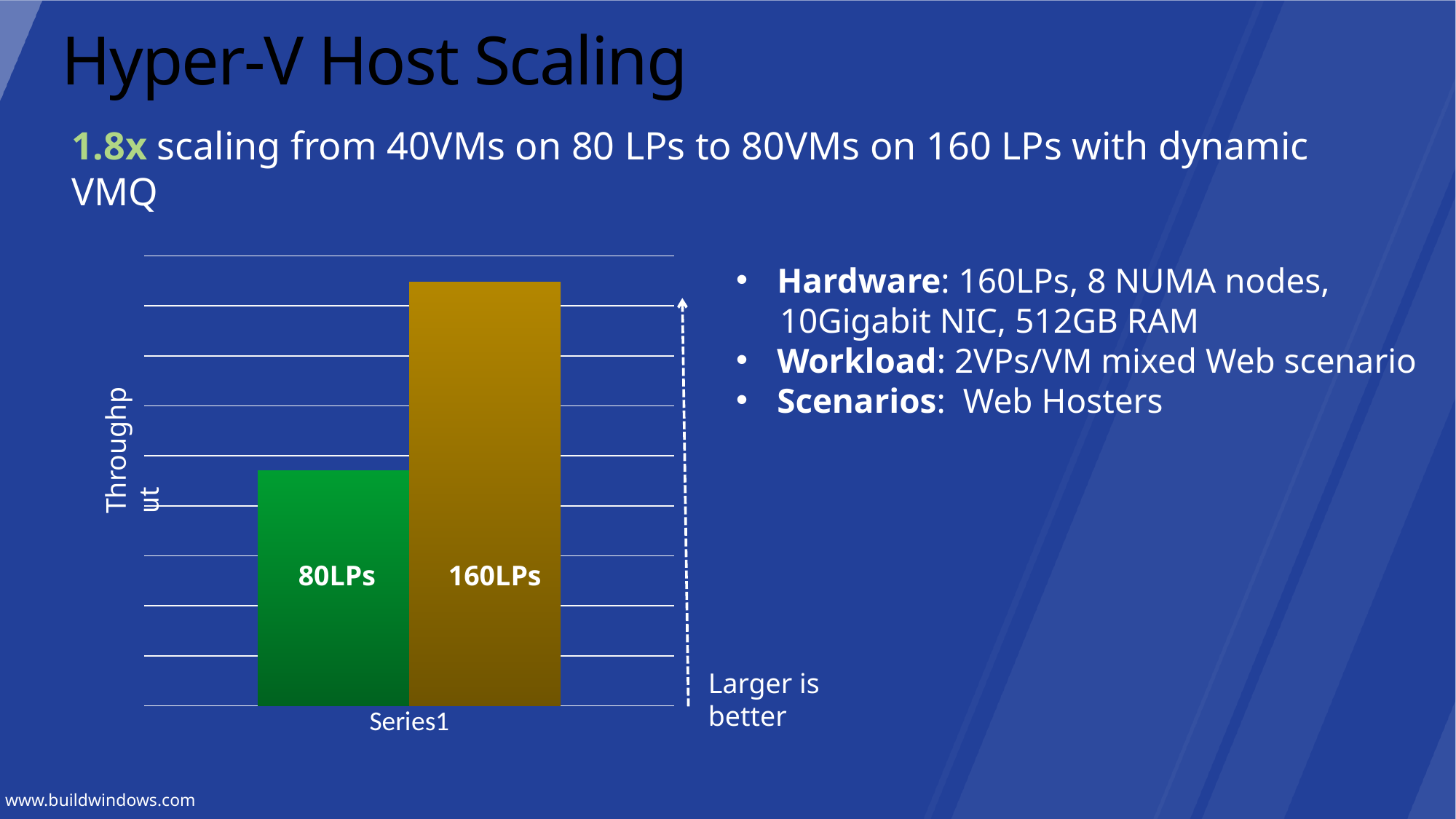
Which bar is the tallest in the chart? 160LPs What is the label on the vertical axis of the chart? Throughput Which bar is taller, 80LPs or 160LPs? 160LPs Does throughput rise or fall going from the 80LPs bar to the 160LPs bar? rise Which bar is the shortest in the chart? 80LPs What is the category label shown under the bars on the horizontal axis? Series1 What kind of chart is shown on the slide? bar chart How many bars are plotted in the chart? 2 What colour is the 80LPs bar? green